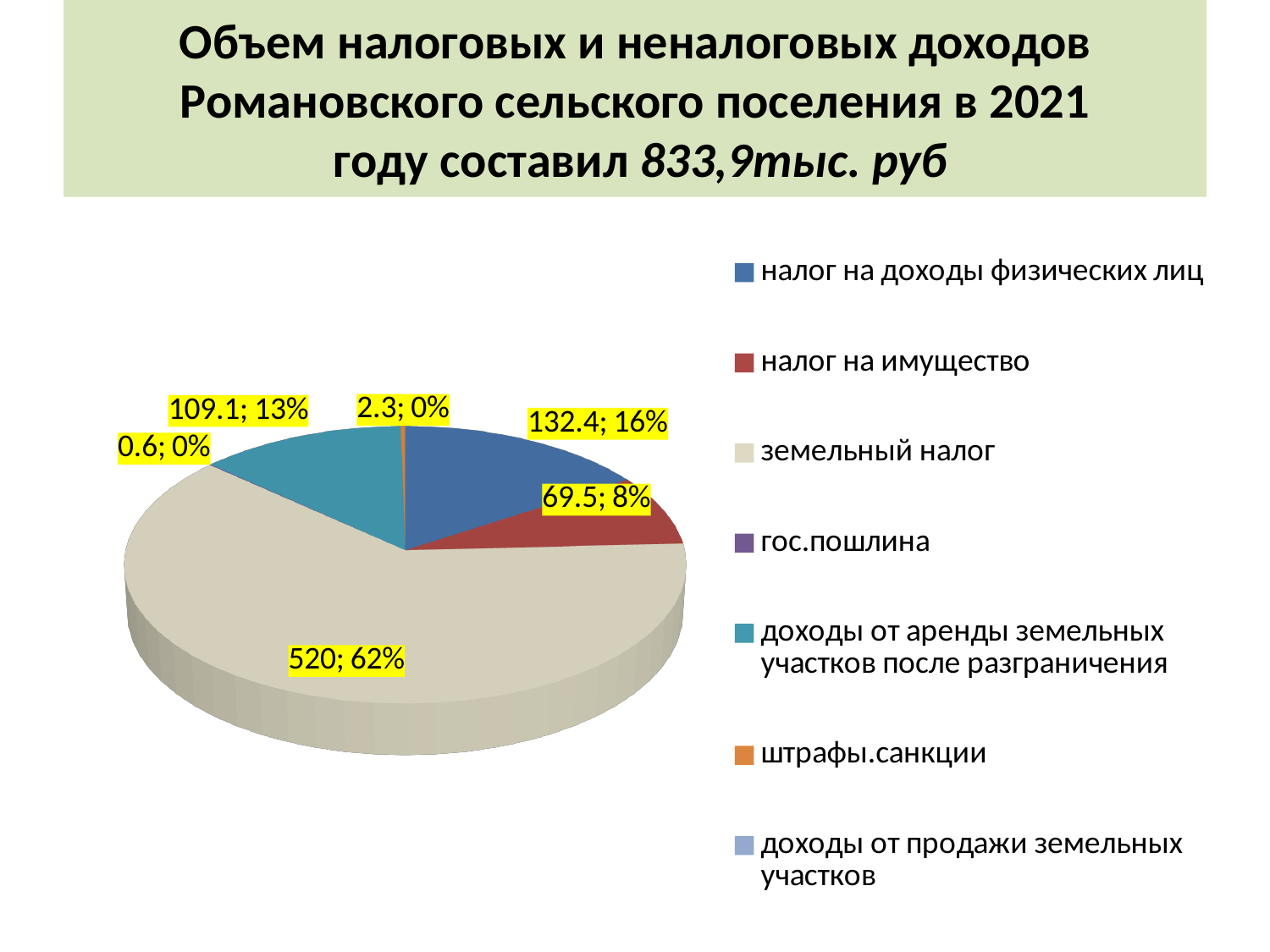
What value is shown for налог на доходы физических лиц? 132.4 What share of the pie does земельный налог take? 62% What kind of chart is shown on the slide? pie chart What is the difference between the values for налог на доходы физических лиц and налог на имущество? 62.9 What value is shown for земельный налог? 520 What value is shown for доходы от аренды земельных участков после разграничения? 109.1 Which category has the largest slice of the pie? земельный налог What share of the pie does налог на имущество take? 8% According to the slide title, what was the total volume of tax and non-tax revenues in 2021? 833,9 тыс. руб Which is larger: налог на доходы физических лиц or налог на имущество? налог на доходы физических лиц What is the difference between the values for земельный налог and доходы от аренды земельных участков после разграничения? 410.9 How many categories does the legend of the pie chart list? 7